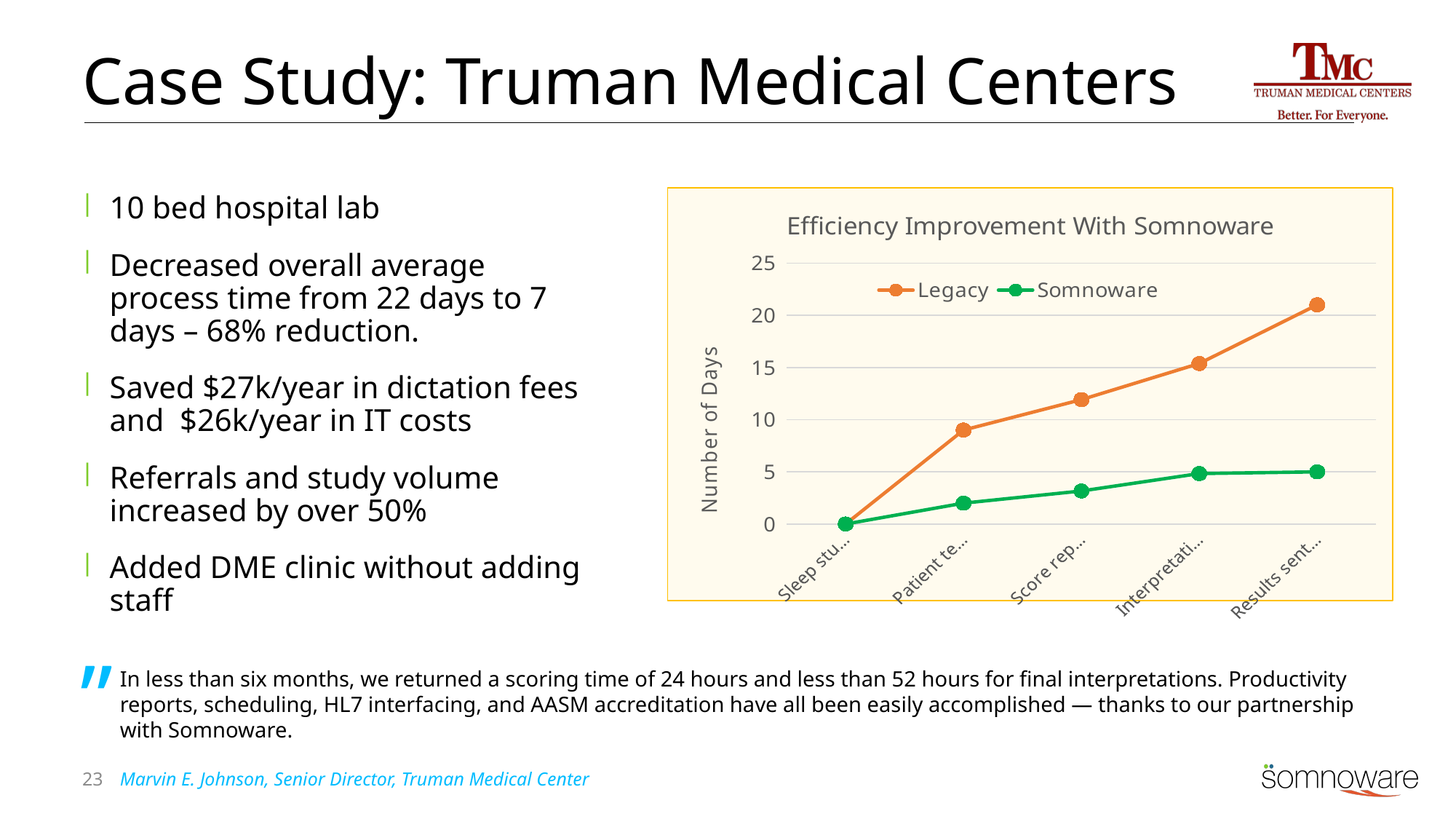
What kind of chart is shown on the slide? line chart Is the Somnoware value at the rightmost point greater or less than 10? less Which series has the lower values across the chart, Legacy or Somnoware? Somnoware What is the label of the chart's y axis? Number of Days Which two series are listed in the chart's legend? Legacy and Somnoware How many points are plotted along the x axis for each series? 5 How many series does the chart's legend list? 2 At the rightmost point on the x axis, which series has the larger value, Legacy or Somnoware? Legacy What is the title of the chart? Efficiency Improvement With Somnoware Do the Legacy values rise or fall from left to right along the x axis? rise Is the Legacy value at the rightmost point greater or less than 20? greater Is the Legacy value at the second point from the left greater or less than 5? greater